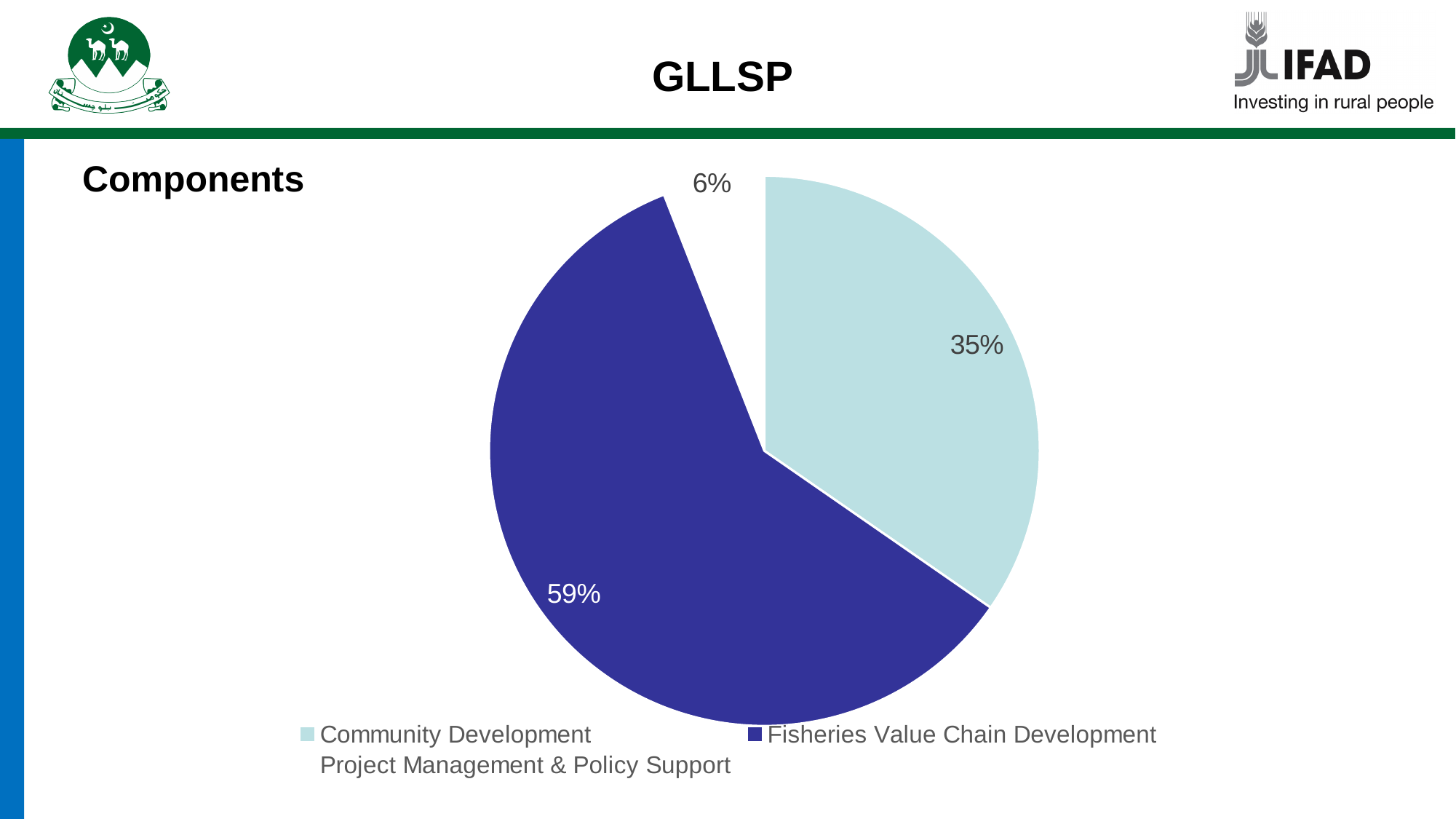
Which is larger, the share for Community Development or the share for Project Management & Policy Support? Community Development What is the heading shown to the left of the pie chart? Components What share of the pie does Fisheries Value Chain Development have? 59% How many slices does the pie chart have? 3 Which component has the largest share of the pie? Fisheries Value Chain Development What kind of chart is shown on the slide? pie chart How many percentage points larger is Fisheries Value Chain Development than Community Development? 24 How many entries does the legend list? 3 What share of the pie does Project Management & Policy Support have? 6% What share of the pie does Community Development have? 35% Which component is shown in dark blue in the pie chart? Fisheries Value Chain Development Which component has the smallest share of the pie? Project Management & Policy Support